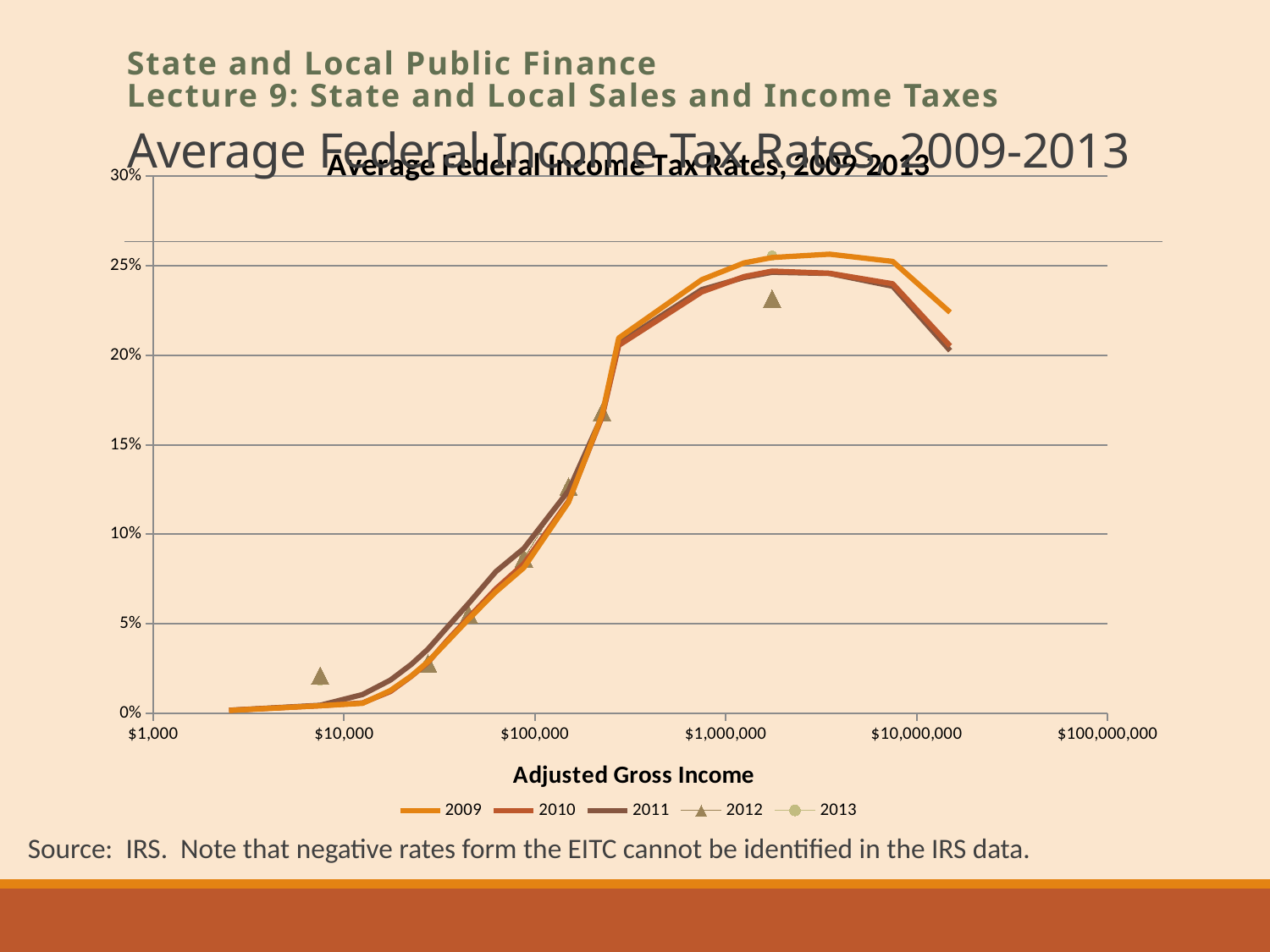
Is the 2011 average tax rate at $10,000 of adjusted gross income greater or less than 5%? less What is the label of the x axis? Adjusted Gross Income At the highest income level plotted (just above $10,000,000), which series has the higher average tax rate, 2009 or 2010? 2009 What kind of chart is shown on the slide? line chart Is the 2009 average tax rate at $100,000 of adjusted gross income greater or less than 10%? less Is the 2010 average tax rate at $10,000,000 of adjusted gross income greater or less than 25%? less How many labeled tick marks are on the x axis? 6 What is the highest value shown on the y axis? 30% How many series does the legend list? 5 What is the title of the chart? Average Federal Income Tax Rates, 2009-2013 Between $10,000 and $100,000 of adjusted gross income, do the average tax rates rise or fall? rise